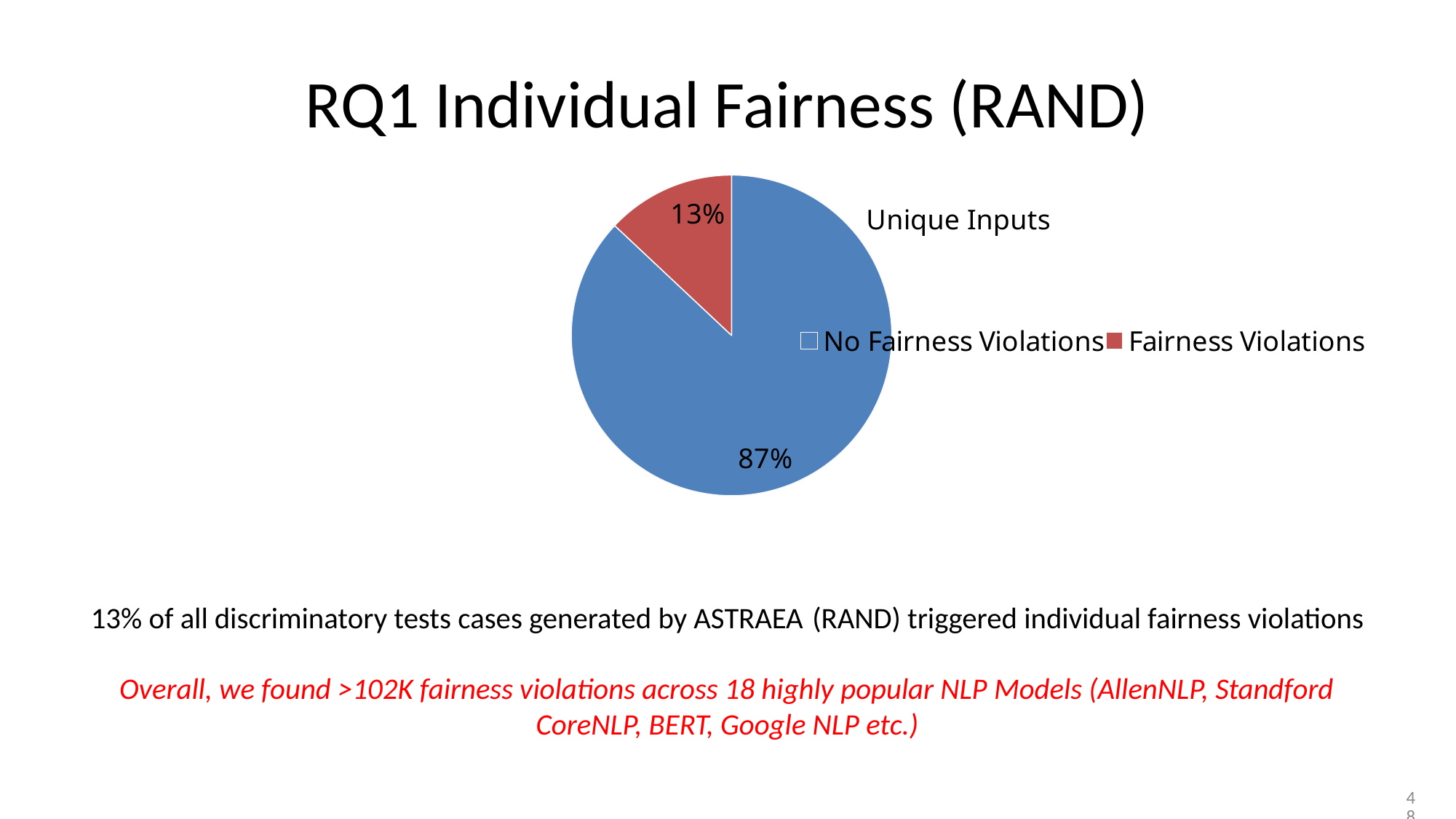
What is the chart's title? Unique Inputs Which slice is the largest? No Fairness Violations What kind of chart is shown on the slide? pie chart What is the difference in percentage points between the No Fairness Violations slice and the Fairness Violations slice? 74 How many slices does the pie chart have? 2 What colour is the Fairness Violations slice? red Which slice is the smallest? Fairness Violations What share of the pie is labelled Fairness Violations? 13% Which is larger, the Fairness Violations slice or the No Fairness Violations slice? No Fairness Violations How many entries does the legend list? 2 What share of the pie is labelled No Fairness Violations? 87%